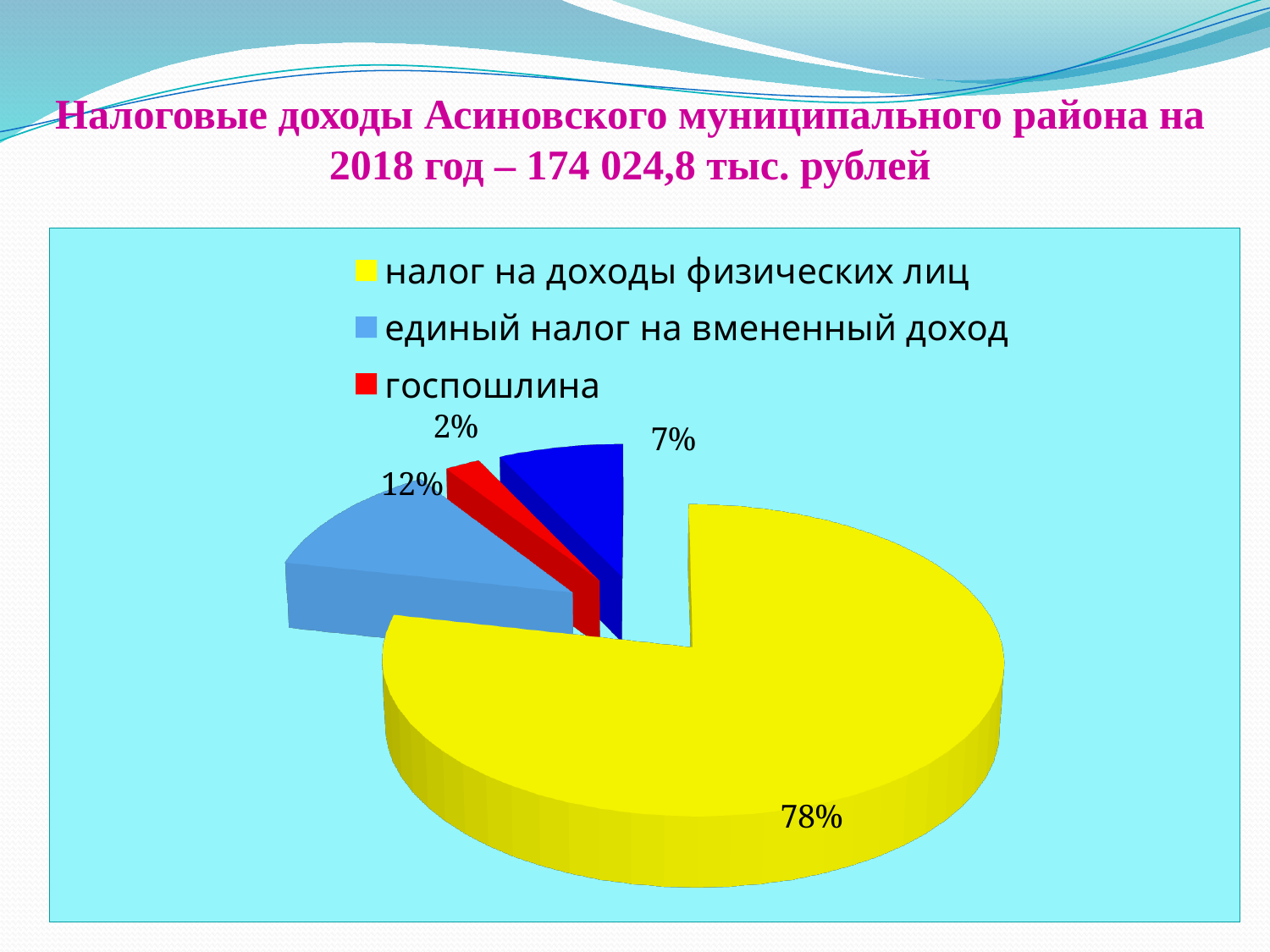
How many entries does the legend list? 3 Which is larger: the slice for единый налог на вмененный доход or the slice for госпошлина? единый налог на вмененный доход According to the slide title, what is the total tax revenue of the Asinovsky municipal district for 2018? 174 024,8 тыс. рублей How many slices does the pie chart have? 4 What kind of chart is shown on the slide? pie chart What colour is the slice for налог на доходы физических лиц? yellow What percentage is shown for единый налог на вмененный доход? 12% By how many percentage points does налог на доходы физических лиц exceed единый налог на вмененный доход? 66 percentage points What share of the pie does налог на доходы физических лиц account for? 78% Which category has the smallest slice of the pie? госпошлина What percentage is shown for госпошлина? 2% Which category has the largest slice of the pie? налог на доходы физических лиц